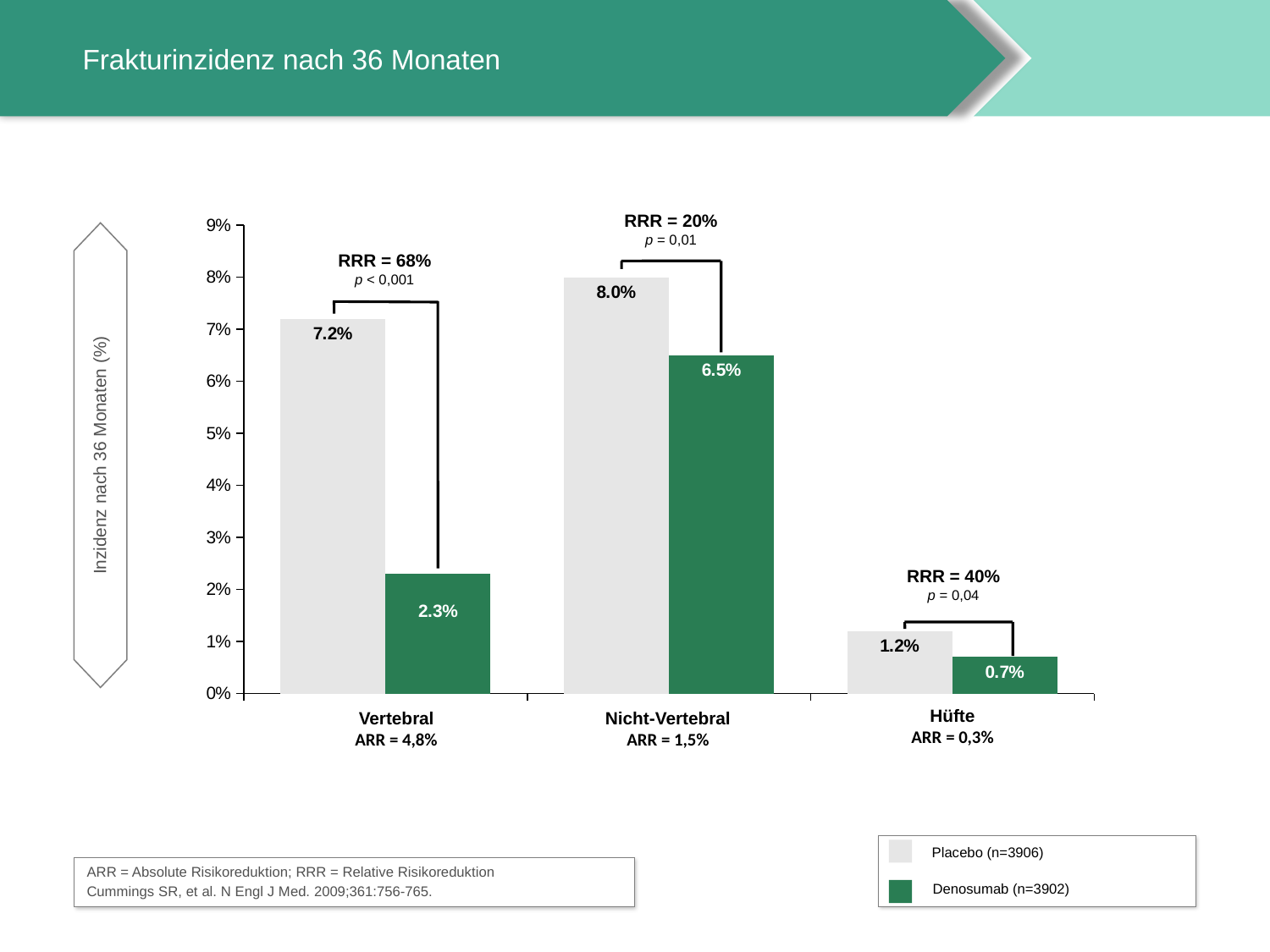
Which is larger for Hüfte: the Placebo incidence or the Denosumab incidence? Placebo What kind of chart is shown on the slide? Bar chart What is the Denosumab fracture incidence for Hüfte? 0.7% Is the Placebo incidence for Nicht-Vertebral fractures greater or less than 7%? greater What is the Placebo fracture incidence for Vertebral fractures? 7.2% Which fracture category has the highest Placebo incidence? Nicht-Vertebral How many series does the legend list? 2 What is the Denosumab fracture incidence for Nicht-Vertebral fractures? 6.5% What is the difference between the Placebo and Denosumab incidence for Vertebral fractures? 4.9% What is the RRR shown for Vertebral fractures? RRR = 68% Which fracture category has the lowest Denosumab incidence? Hüfte How many fracture categories are shown on the x axis? 3